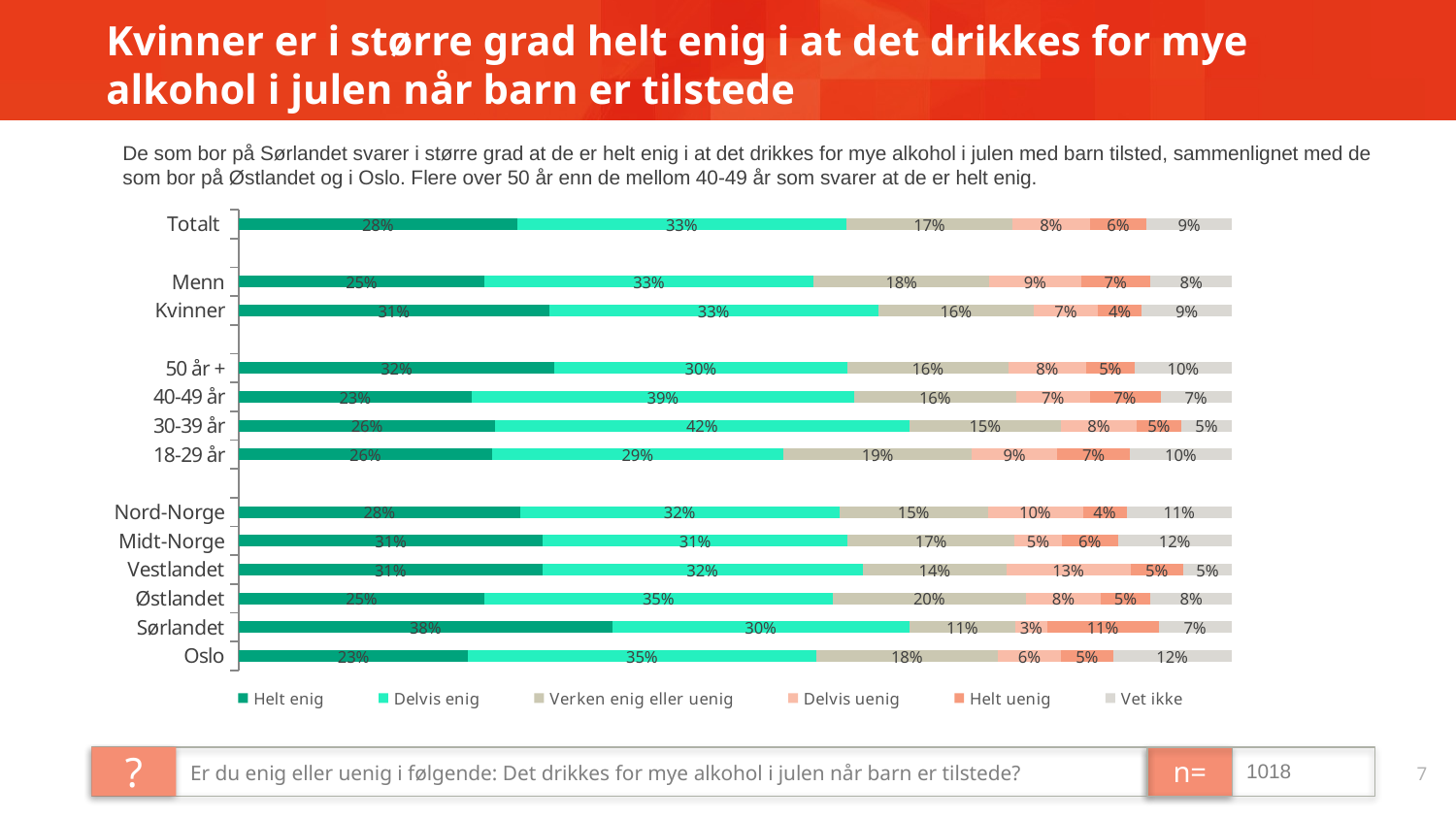
What kind of chart is shown on the slide? Stacked bar chart What is the 'Vet ikke' value for Oslo? 12% What is the last entry in the chart legend? Vet ikke What is the 'Helt uenig' value for Sørlandet? 11% Which category has the lowest 'Helt enig' value? Oslo and 40-49 år (both 23%) Which is larger, the 'Helt enig' value for 50 år + or for 40-49 år? 50 år + How many categories are plotted on the chart? 13 Which category has the highest 'Helt enig' value? Sørlandet How many series does the legend list? 6 What is the 'Helt enig' value for Kvinner? 31% What is the 'Delvis enig' value for 30-39 år? 42% What is the difference between the 'Helt enig' values for Kvinner and Menn? 6%